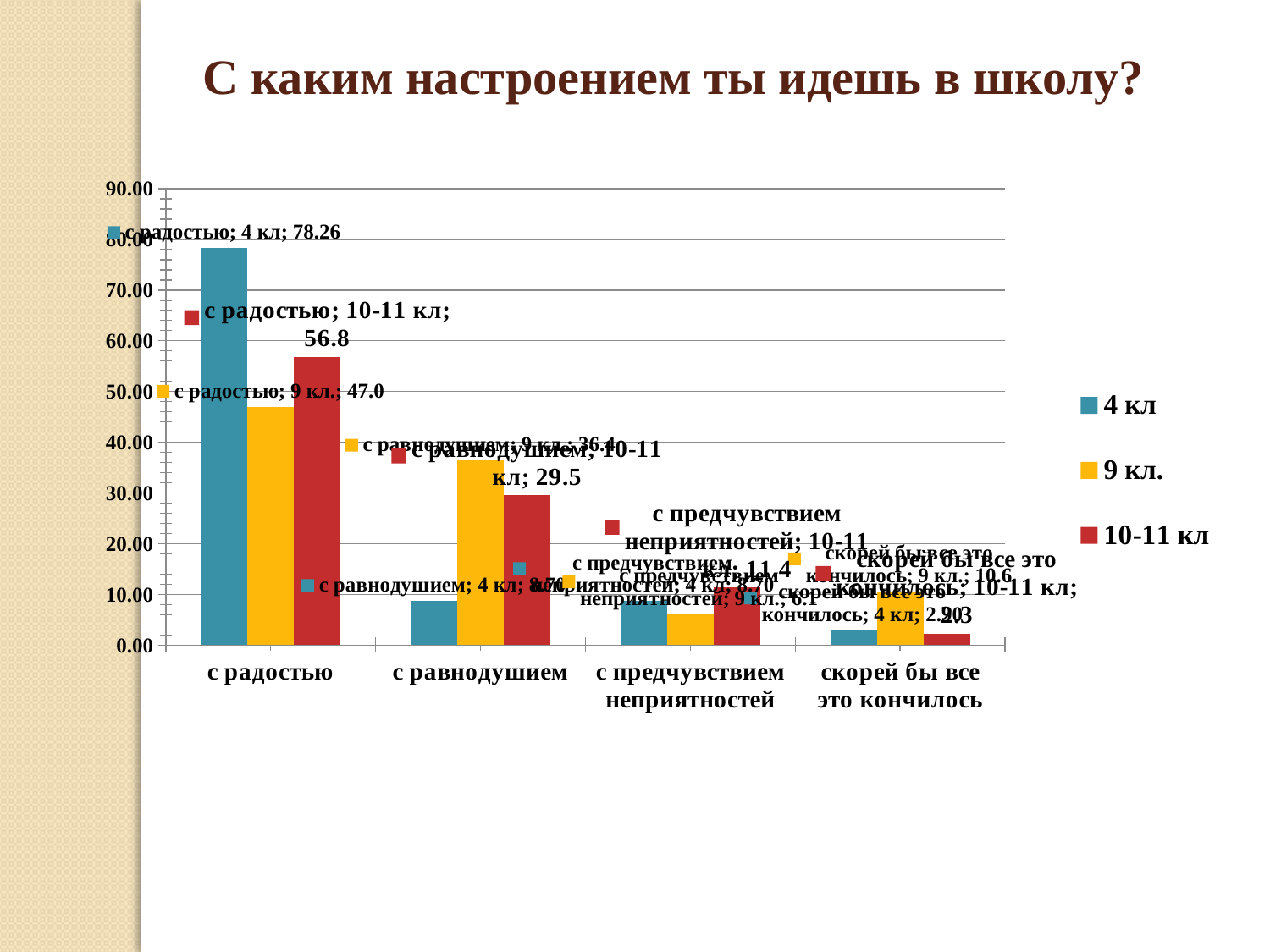
What is the value for 4 кл in the category с радостью? 78.26 What is the value for 10-11 кл in the category с предчувствием неприятностей? 11.4 What is the value for 10-11 кл in the category с радостью? 56.8 What is the value for 10-11 кл in the category с равнодушием? 29.5 Which series has the highest value in the category с радостью? 4 кл In the category с радостью, which is larger: the value for 9 кл. or for 10-11 кл? 10-11 кл What kind of chart is shown on the slide? bar chart What is the value for 9 кл. in the category скорей бы все это кончилось? 10.6 How many series does the legend list? 3 Is the value for 4 кл in the category с равнодушием greater or less than 10.00? less What is the difference between the 4 кл and 10-11 кл values in the category с радостью? 21.46 What is the value for 9 кл. in the category с радостью? 47.0